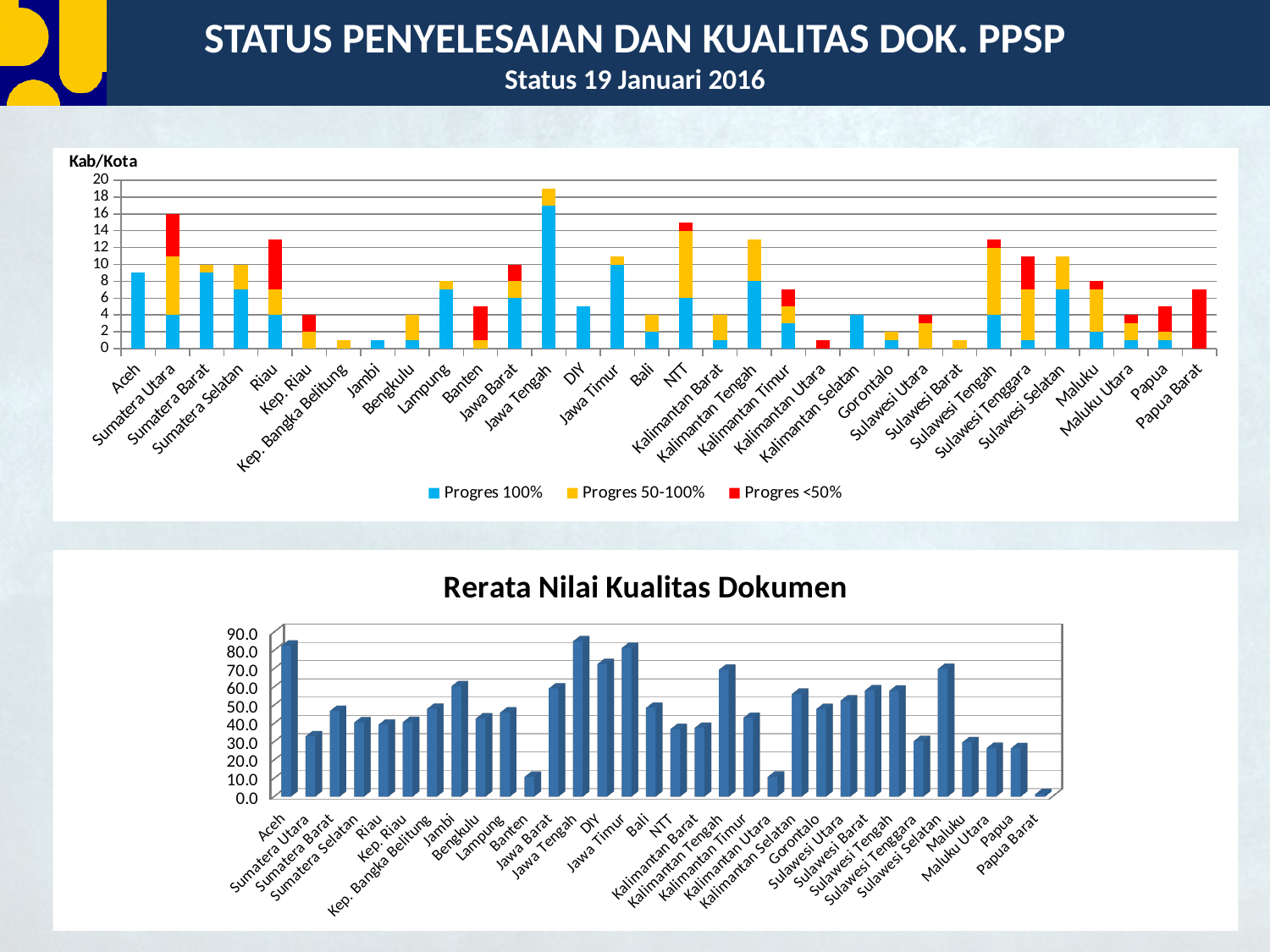
In the top chart, which has the taller stacked bar, Aceh or Kalimantan Utara? Aceh What kind of chart is the top chart on the slide? Stacked bar chart In the top chart, which province has the tallest stacked bar? Jawa Tengah In the bottom chart 'Rerata Nilai Kualitas Dokumen', is the value for Banten greater or less than 20.0? less In the bottom chart 'Rerata Nilai Kualitas Dokumen', is the value for Aceh greater or less than 70.0? greater In the top chart, is the total stacked value for Jawa Tengah greater or less than 16? greater In the top chart, which colour represents the series 'Progres <50%'? Red In the bottom chart 'Rerata Nilai Kualitas Dokumen', which is larger, the value for Sumatera Utara or Sumatera Barat? Sumatera Barat What is the title of the bottom chart? Rerata Nilai Kualitas Dokumen In the top chart, how many series does the legend list? 3 In the bottom chart 'Rerata Nilai Kualitas Dokumen', which province has the lowest value? Papua Barat